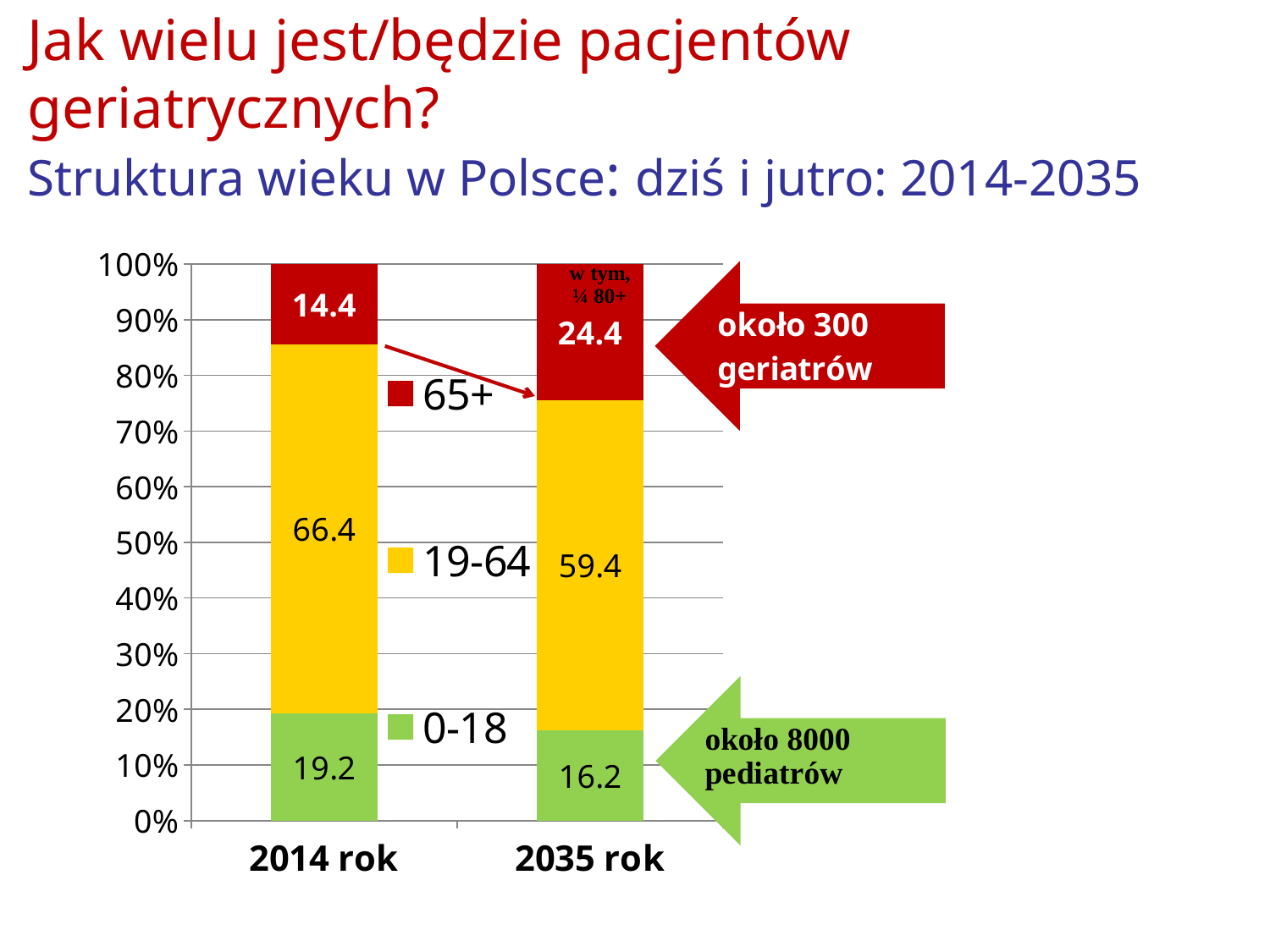
What kind of chart is shown on the slide? stacked bar chart By how much does the 65+ value change from 2014 rok to 2035 rok? 10.0 Which year has the larger value for the 0-18 series, 2014 rok or 2035 rok? 2014 rok Which colour represents the 65+ series in the legend? red How many series does the legend list? 3 How many categories are shown on the x axis? 2 What is the value for the 65+ series in 2014 rok? 14.4 What is the value for the 0-18 series in 2035 rok? 16.2 What is the value for the 19-64 series in 2014 rok? 66.4 What is the value for the 65+ series in 2035 rok? 24.4 Does the 19-64 series rise or fall from 2014 rok to 2035 rok? fall What is the difference between the 19-64 values for 2014 rok and 2035 rok? 7.0